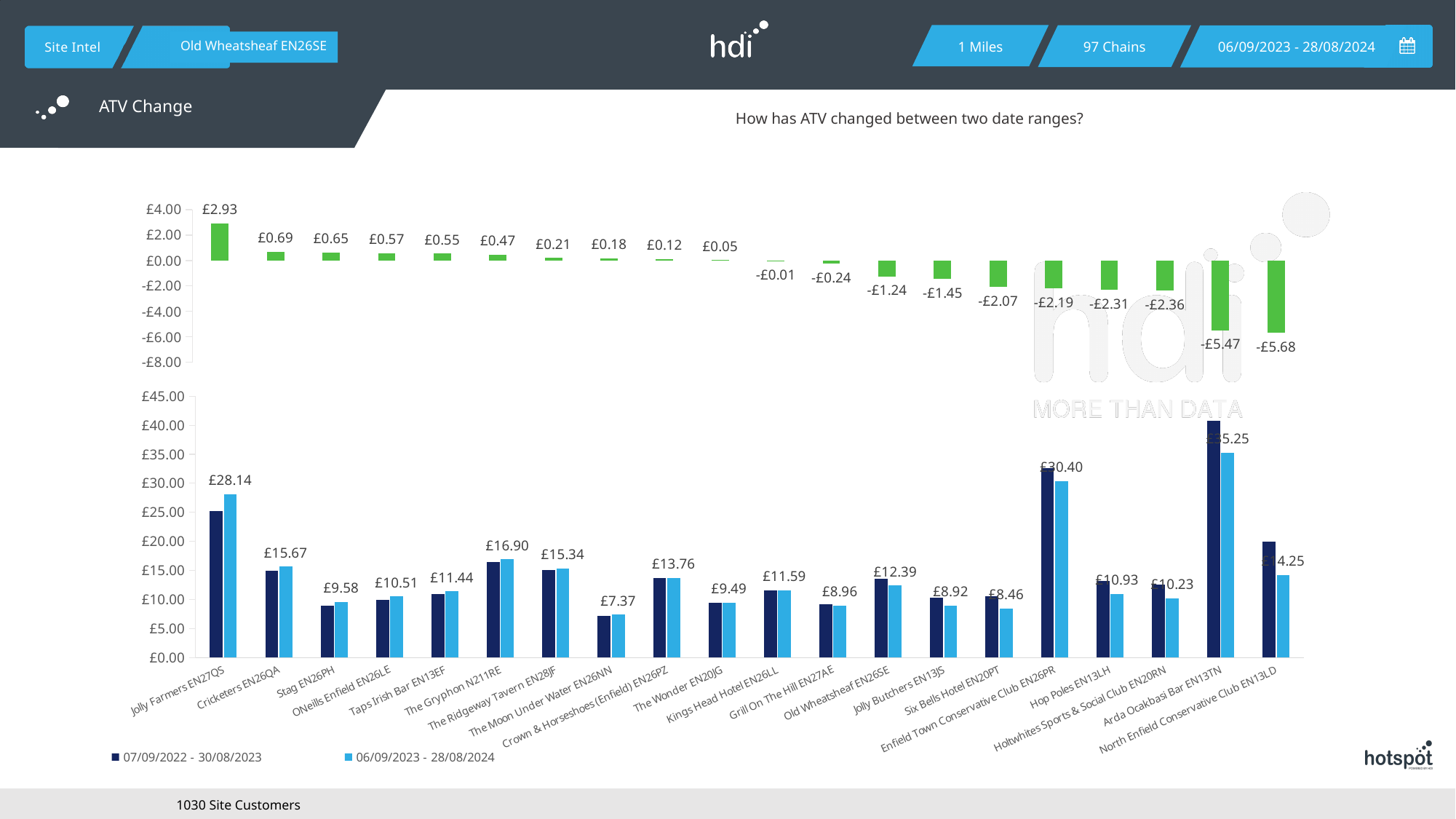
How many series does the legend of the bottom chart list? 2 In the top chart, what is the largest labelled value? £2.93 In the top chart, what is the smallest labelled value? -£5.68 In the bottom chart, which has the larger labelled 06/09/2023 - 28/08/2024 value: Enfield Town Conservative Club EN26PR or Old Wheatsheaf EN26SE? Enfield Town Conservative Club EN26PR In the bottom chart, is the 07/09/2022 - 30/08/2023 value for Arda Ocakbasi Bar EN13TN greater or less than £40.00? greater In the bottom chart, what is the difference between the labelled 06/09/2023 - 28/08/2024 values for Jolly Farmers EN27QS and Cricketers EN26QA? £12.47 In the bottom chart, what is the labelled value for Arda Ocakbasi Bar EN13TN in the 06/09/2023 - 28/08/2024 period? £35.25 What type of chart is the bottom chart? bar chart In the bottom chart, which category has the lowest labelled value for the 06/09/2023 - 28/08/2024 period? The Moon Under Water EN26NN In the bottom chart, which category has the highest labelled value for the 06/09/2023 - 28/08/2024 period? Arda Ocakbasi Bar EN13TN In the bottom chart, what is the labelled value for The Moon Under Water EN26NN in the 06/09/2023 - 28/08/2024 period? £7.37 How many categories are shown on the x axis of the bottom chart? 20